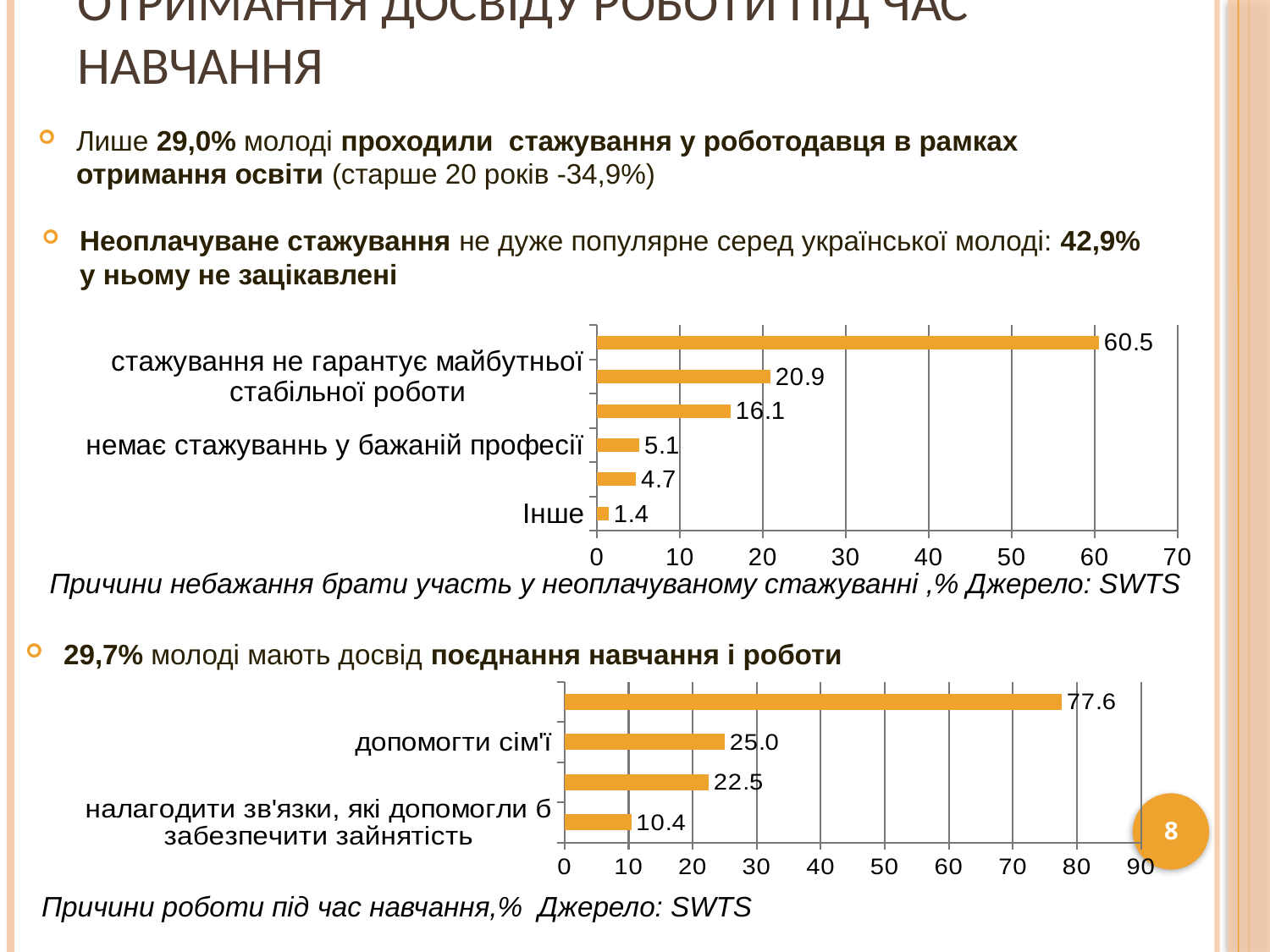
In the top chart, 'Причини небажання брати участь у неоплачуваному стажуванні', which category has the lowest value? Інше In the bottom chart, 'Причини роботи під час навчання', is the value for 'допомогти сім'ї' greater or less than 20? greater In the bottom chart, 'Причини роботи під час навчання', what is the highest value shown? 77.6 In the top chart, 'Причини небажання брати участь у неоплачуваному стажуванні', what is the value for 'Інше'? 1.4 In the bottom chart, 'Причини роботи під час навчання', how many bars are plotted? 4 In the top chart, 'Причини небажання брати участь у неоплачуваному стажуванні', how many bars are plotted? 6 In the top chart, 'Причини небажання брати участь у неоплачуваному стажуванні', what is the value for 'немає стажуваннь у бажаній професії'? 5.1 What kind of chart is the top chart, 'Причини небажання брати участь у неоплачуваному стажуванні'? bar chart In the bottom chart, 'Причини роботи під час навчання', what is the value for 'налагодити зв'язки, які допомогли б забезпечити зайнятість'? 10.4 In the bottom chart, 'Причини роботи під час навчання', what is the value for 'допомогти сім'ї'? 25.0 In the top chart, 'Причини небажання брати участь у неоплачуваному стажуванні', what is the highest value shown? 60.5 In the top chart, 'Причини небажання брати участь у неоплачуваному стажуванні', what is the difference between the largest value (60.5) and the second largest (20.9)? 39.6